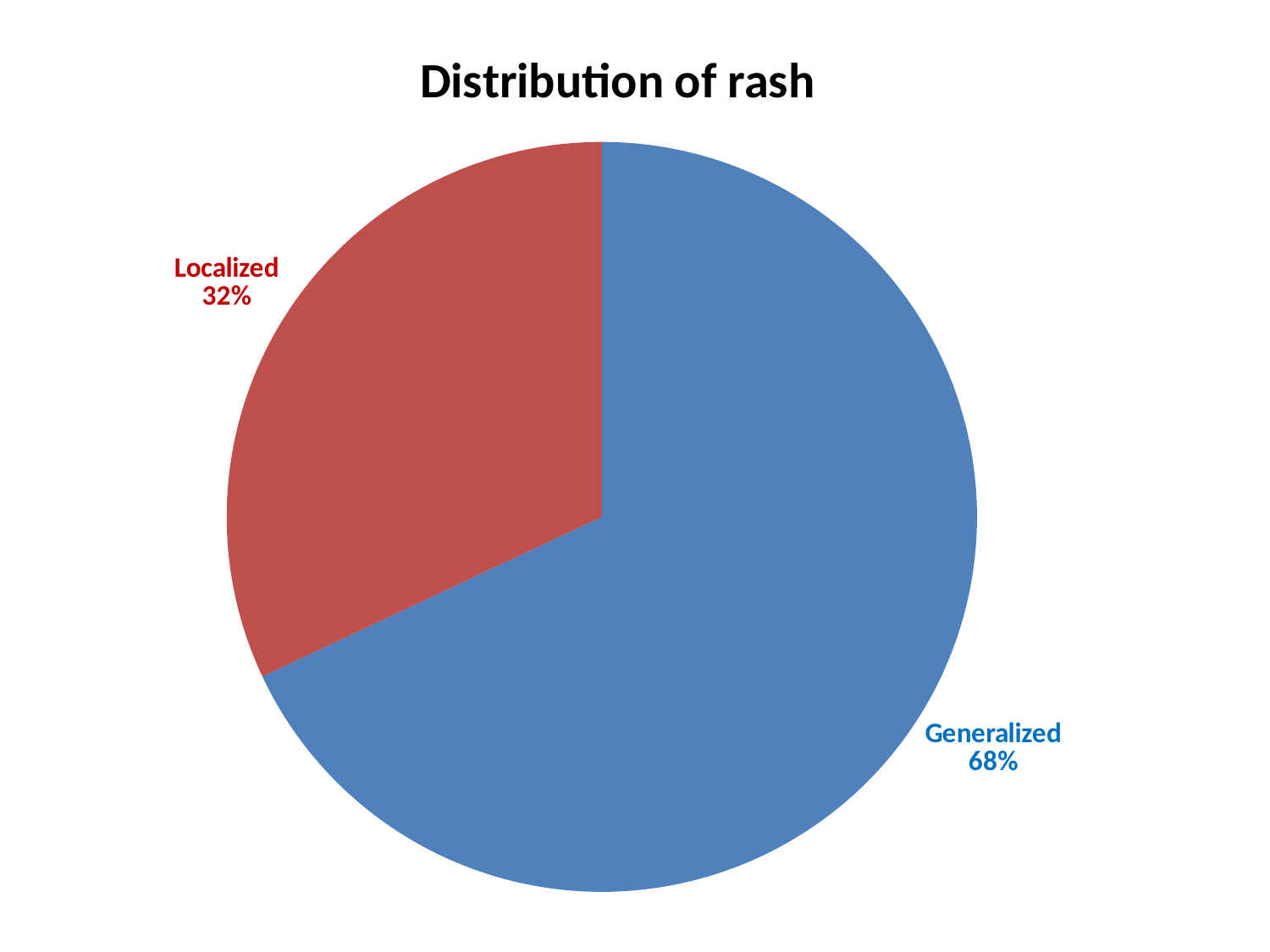
What share of the pie does the Generalized slice represent? 68% Which category has the smallest share of the pie? Localized What is the title of the chart? Distribution of rash What percentage of the pie is Generalized? 68% What kind of chart is shown on the slide? Pie chart What is the difference in percentage points between Generalized and Localized? 36 What colour is the Localized slice? Red Which category has the largest share of the pie? Generalized How many slices does the pie chart have? 2 What percentage of the pie is Localized? 32% Which is larger, the Generalized slice or the Localized slice? Generalized